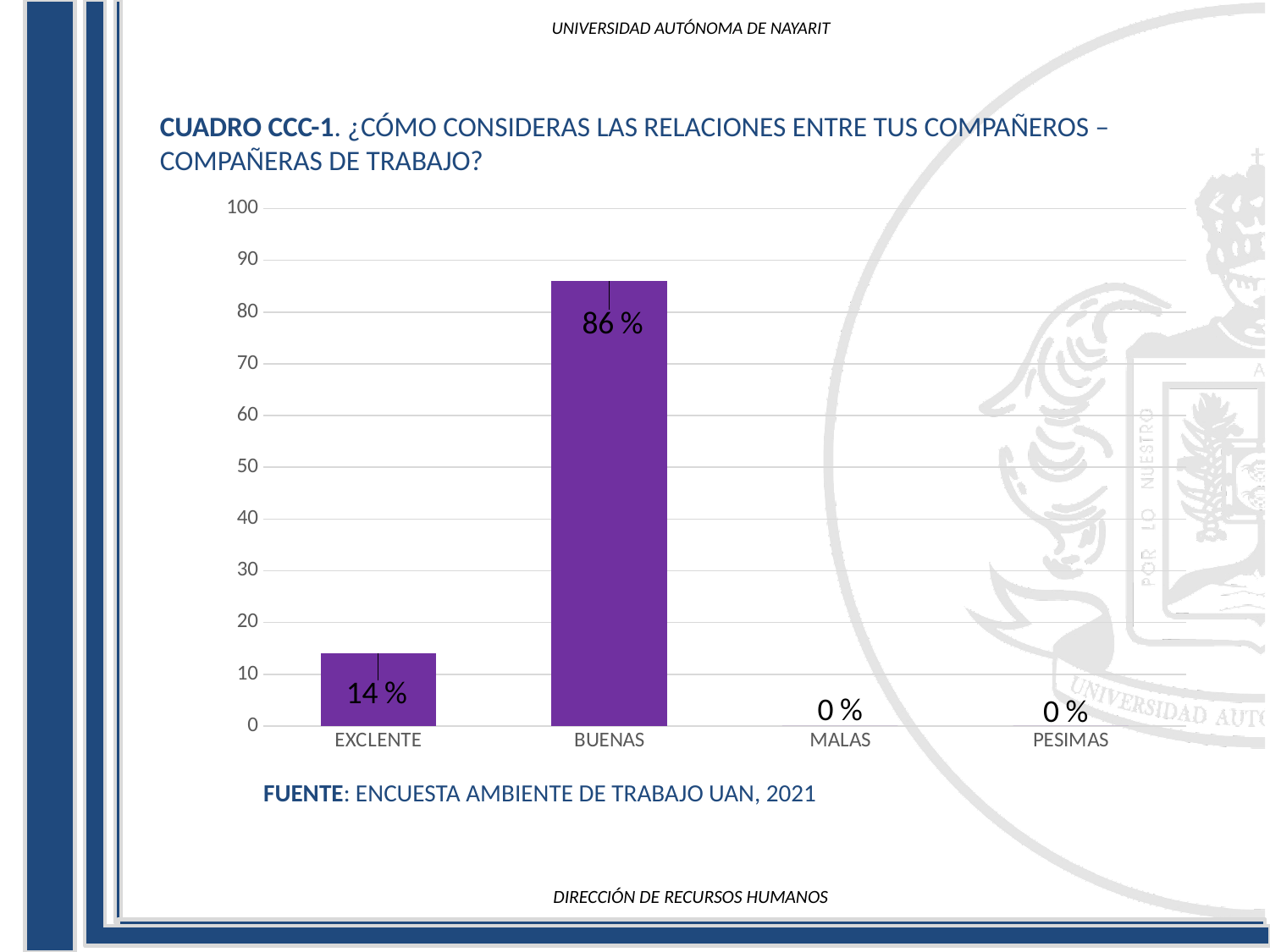
What source is cited below the chart? ENCUESTA AMBIENTE DE TRABAJO UAN, 2021 Which is larger, the value for EXCLENTE or the value for BUENAS? BUENAS What is the value for EXCLENTE? 14 % Is the value for EXCLENTE greater or less than 20? less What kind of chart is shown on the slide? bar chart Which category has the highest value? BUENAS What is the value for PESIMAS? 0 % Is the value for BUENAS greater or less than 80? greater How many categories are shown on the x axis? 4 What is the difference between the values for BUENAS and EXCLENTE? 72 % What is the value for BUENAS? 86 % What is the value for MALAS? 0 %